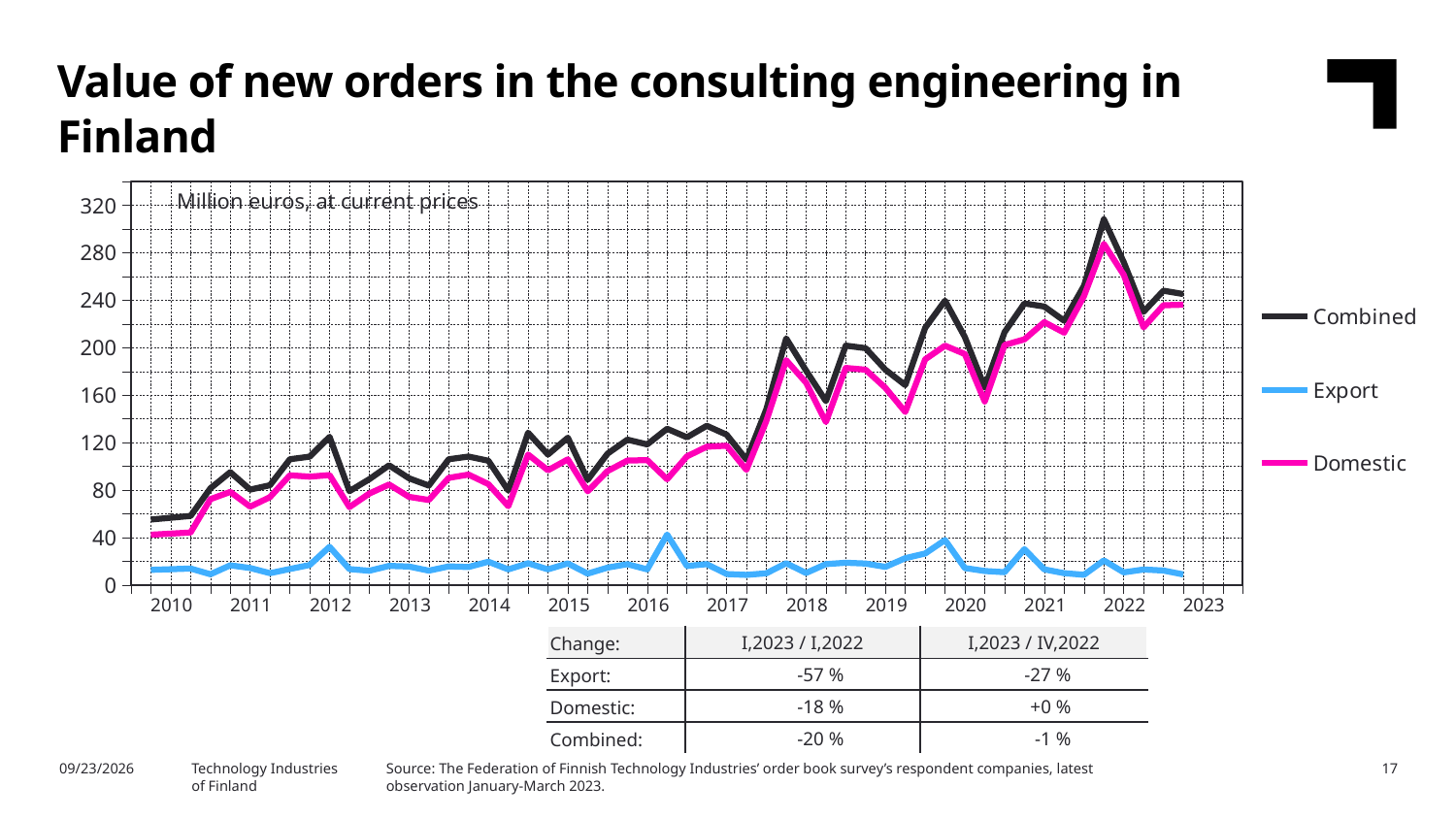
What kind of chart is shown on the slide? line chart Is the value of the Combined series at the start of 2010 greater or less than 40? greater What are the three series named in the legend? Combined, Export, Domestic Which series has the highest values throughout the chart? Combined How many series does the legend list? 3 Is the value of the Combined series at the last observation in 2023 greater or less than 200? greater Overall, does the Combined series rise or fall from 2010 to 2023? rise Which series has the lowest values throughout the chart? Export In 2020, which series is larger, Domestic or Export? Domestic What unit is stated in the label inside the chart area? Million euros, at current prices How many years are labelled on the x axis? 14